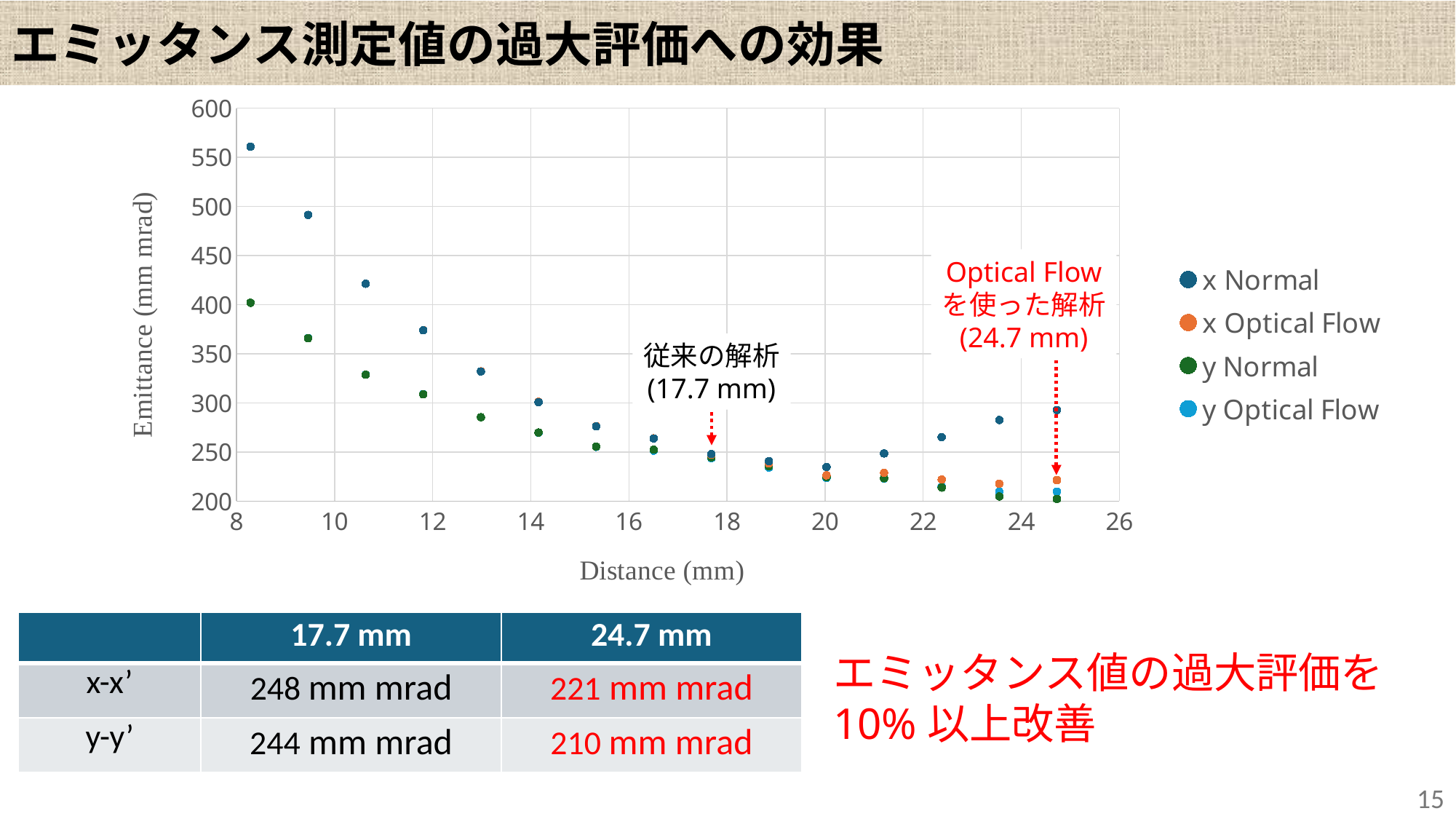
According to the table below the chart, what is the x-x' emittance at 24.7 mm? 221 mm mrad What kind of chart is shown on the slide? scatter chart Which series has the highest emittance value on the chart? x Normal According to the table below the chart, what is the difference between the y-y' emittance at 17.7 mm and at 24.7 mm? 34 mm mrad How many series does the chart legend list? 4 Between 8 mm and 18 mm, do the x Normal emittance values rise or fall as distance increases? fall Is the y Normal value at about 10.6 mm greater or less than 350? less Is the x Normal value at the leftmost distance (about 8 mm) greater or less than 500? greater What is the label of the chart's x axis? Distance (mm) At 24.7 mm, which is larger: the x Normal value or the x Optical Flow value? x Normal Is the y Normal value at the leftmost distance (about 8 mm) greater or less than 450? less What is the label of the chart's y axis? Emittance (mm mrad)